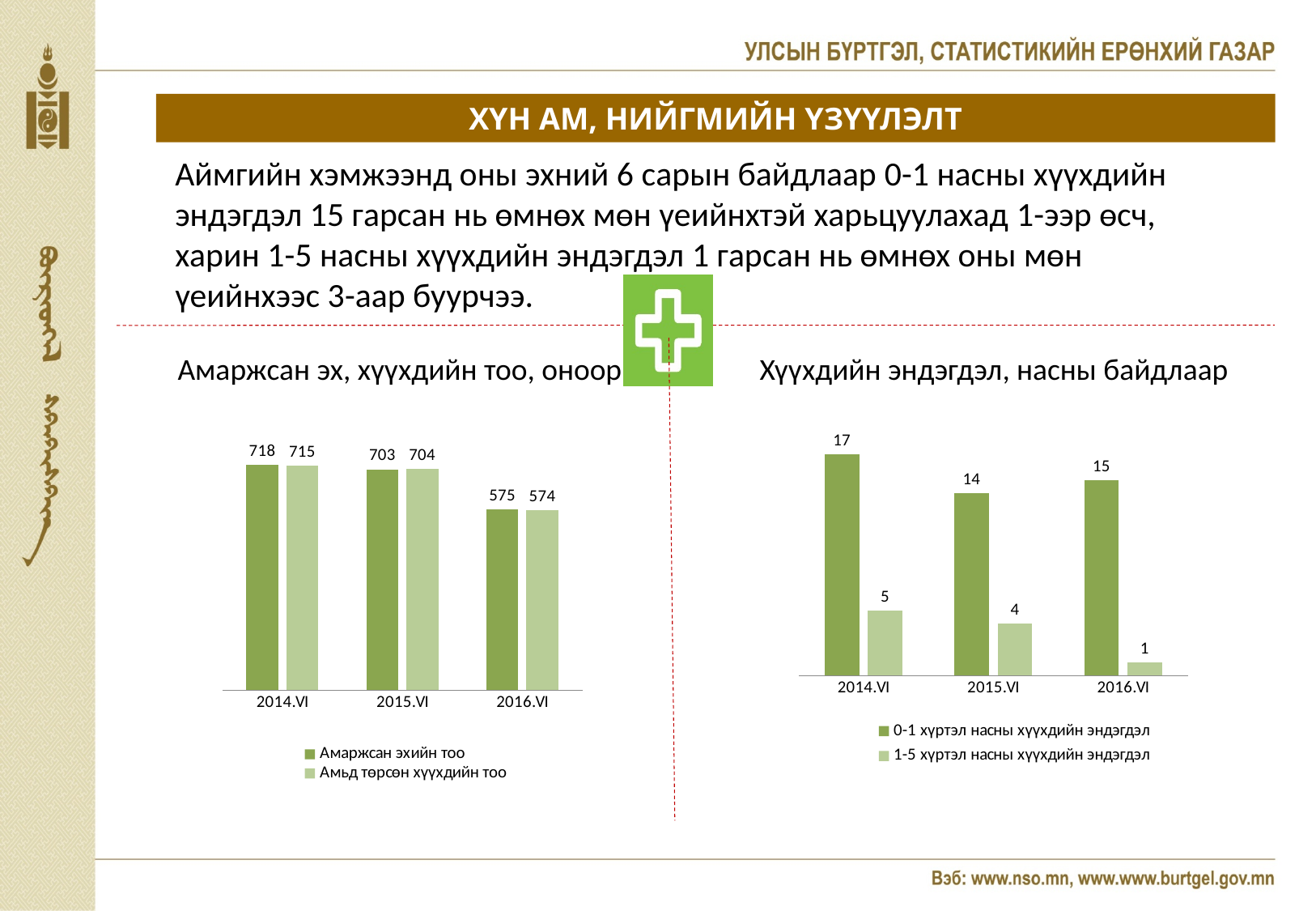
In the right chart (Хүүхдийн эндэгдэл, насны байдлаар), what is the value of 1-5 хүртэл насны хүүхдийн эндэгдэл for 2016.VI? 1 What type of chart is the right chart (Хүүхдийн эндэгдэл, насны байдлаар)? bar chart In the left chart (Амаржсан эх, хүүхдийн тоо, оноор), what is the value of Амьд төрсөн хүүхдийн тоо for 2016.VI? 574 In the left chart (Амаржсан эх, хүүхдийн тоо, оноор), how many series does the legend list? 2 In the left chart (Амаржсан эх, хүүхдийн тоо, оноор), what is the difference between Амаржсан эхийн тоо in 2014.VI and 2016.VI? 143 In the right chart (Хүүхдийн эндэгдэл, насны байдлаар), how many periods are shown on the x axis? 3 In the right chart (Хүүхдийн эндэгдэл, насны байдлаар), what is the difference between 0-1 хүртэл насны хүүхдийн эндэгдэл and 1-5 хүртэл насны хүүхдийн эндэгдэл in 2014.VI? 12 In the right chart (Хүүхдийн эндэгдэл, насны байдлаар), what is the value of 0-1 хүртэл насны хүүхдийн эндэгдэл for 2015.VI? 14 In the left chart (Амаржсан эх, хүүхдийн тоо, оноор), does Амаржсан эхийн тоо rise or fall from 2014.VI to 2016.VI? fall In the left chart (Амаржсан эх, хүүхдийн тоо, оноор), which period has the lowest value for Амаржсан эхийн тоо? 2016.VI In the left chart (Амаржсан эх, хүүхдийн тоо, оноор), what is the value of Амаржсан эхийн тоо for 2014.VI? 718 In the right chart (Хүүхдийн эндэгдэл, насны байдлаар), which period has the highest value for 0-1 хүртэл насны хүүхдийн эндэгдэл? 2014.VI